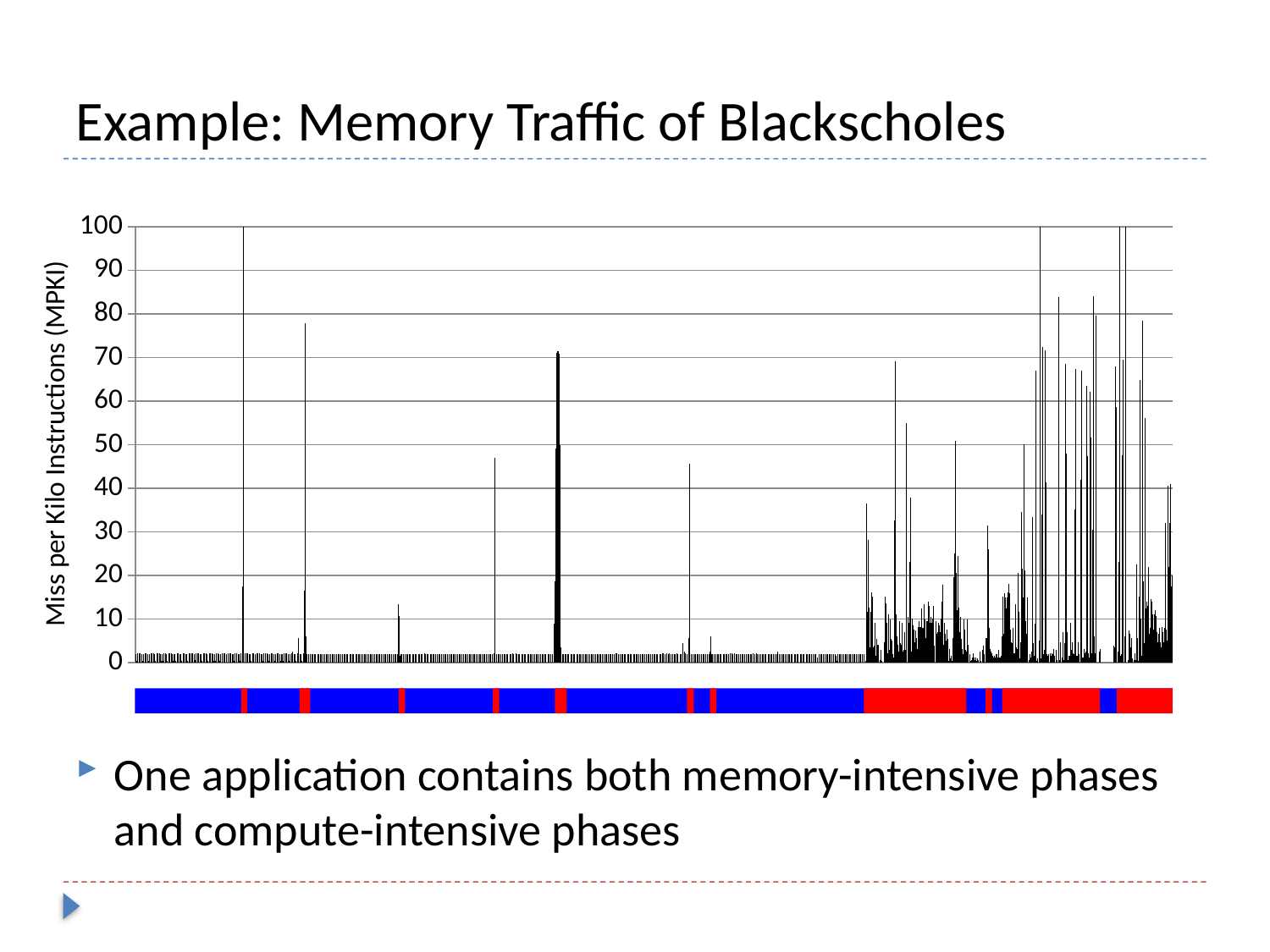
Does the chart include a legend? No What is the label of the y axis of the chart? Miss per Kilo Instructions (MPKI) Is the tall spike near the middle of the chart greater or less than 60 MPKI? greater Do the values in the chart generally rise or fall moving from left to right along the x axis? rise Is the first tall spike on the left side of the chart greater or less than 90 MPKI? greater What kind of chart is shown on the slide? bar chart Is the tall spike near the middle of the chart greater or less than 80 MPKI? less